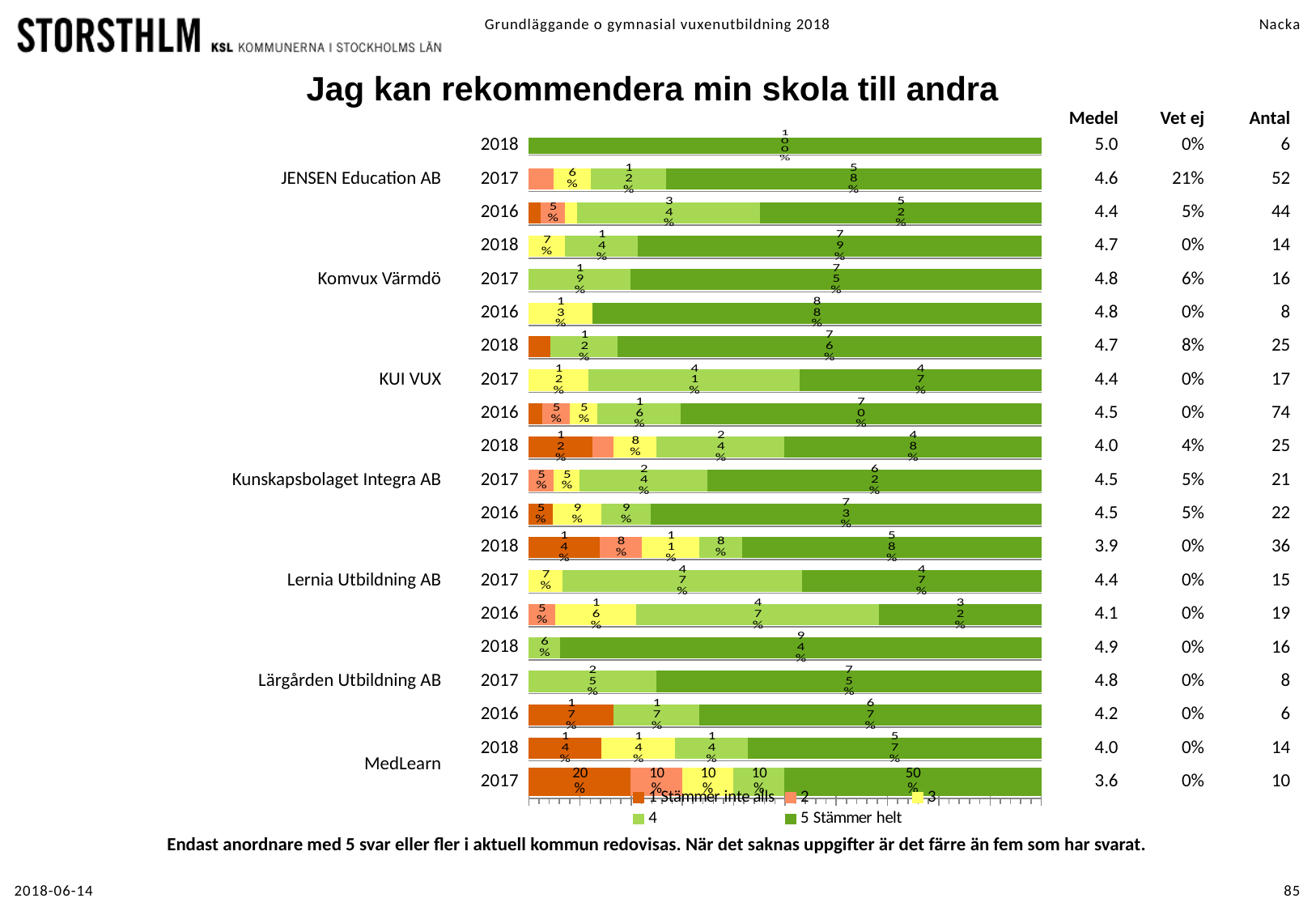
For Komvux Värmdö 2016, how many percentage points larger is the '5 Stämmer helt' share than the '3' share? 75 percentage points How many bars are plotted in the chart? 20 What percentage of the Kunskapsbolaget Integra AB 2018 bar is series '4'? 24% How many series does the chart legend list? 5 What percentage of the MedLearn 2017 bar is '1 Stämmer inte alls'? 20% What percentage of the JENSEN Education AB 2018 bar is '5 Stämmer helt'? 100% Which has a larger '5 Stämmer helt' share, Lernia Utbildning AB 2018 or Lärgården Utbildning AB 2018? Lärgården Utbildning AB 2018 What is the title of the chart? Jag kan rekommendera min skola till andra What percentage of the MedLearn 2017 bar is '5 Stämmer helt'? 50% What percentage of the Lärgården Utbildning AB 2018 bar is '5 Stämmer helt'? 94% Which bar has the highest '5 Stämmer helt' share? JENSEN Education AB 2018 What kind of chart is shown on the slide? bar chart